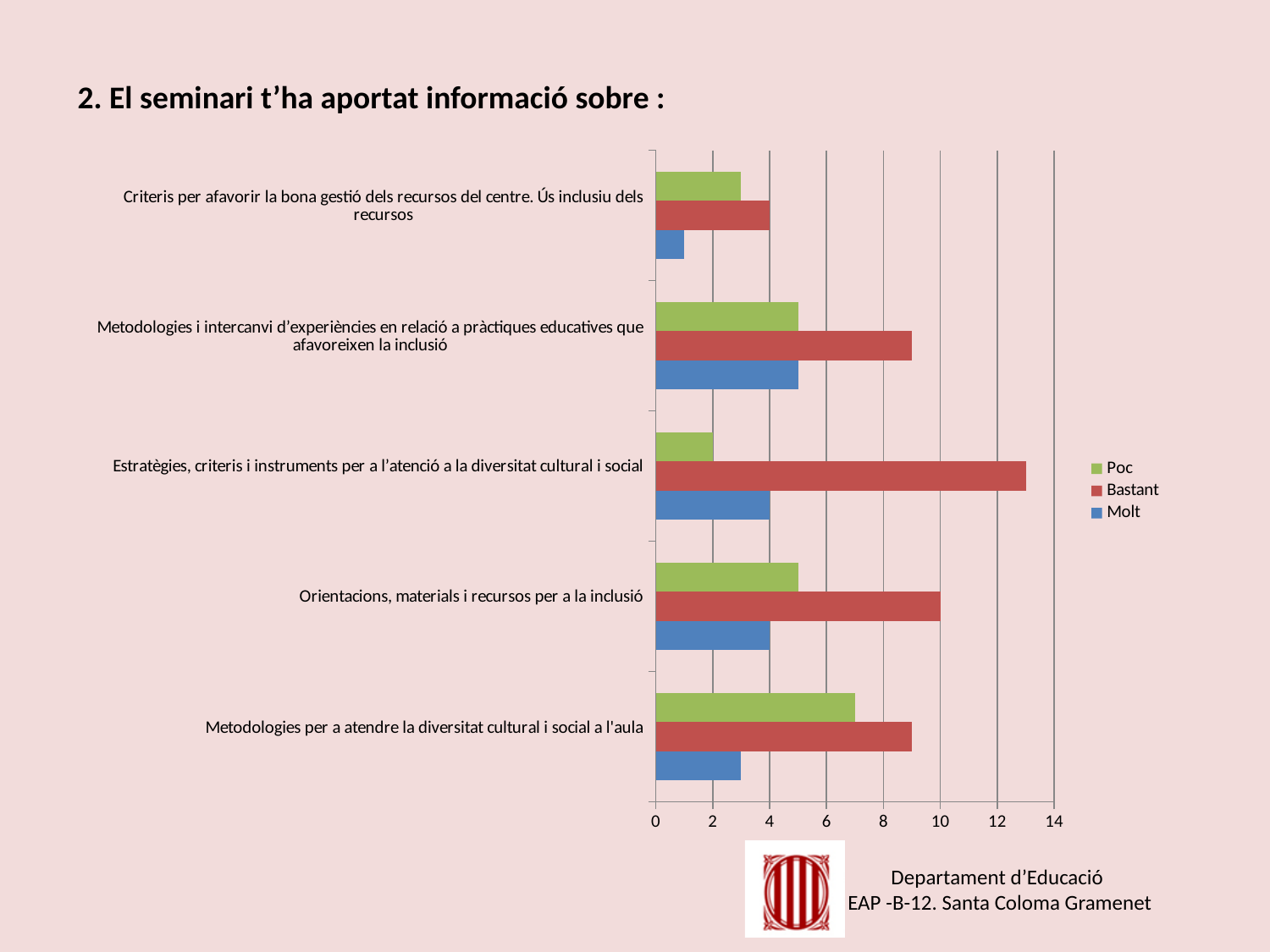
Which category has the highest 'Bastant' value? Estratègies, criteris i instruments per a l'atenció a la diversitat cultural i social How many series does the legend list? 3 For 'Estratègies, criteris i instruments per a l'atenció a la diversitat cultural i social', which is larger: the 'Bastant' value or the 'Poc' value? Bastant How many categories are plotted on the chart? 5 What is the 'Bastant' value for 'Criteris per afavorir la bona gestió dels recursos del centre. Ús inclusiu dels recursos'? 4 Is the 'Poc' value for 'Metodologies per a atendre la diversitat cultural i social a l'aula' greater or less than 6? greater Which legend entry is shown in green? Poc What is the 'Poc' value for 'Estratègies, criteris i instruments per a l'atenció a la diversitat cultural i social'? 2 What is the 'Bastant' value for 'Orientacions, materials i recursos per a la inclusió'? 10 What kind of chart is shown on the slide? bar chart Is the 'Molt' value for 'Criteris per afavorir la bona gestió dels recursos del centre. Ús inclusiu dels recursos' greater or less than 2? less Which category has the lowest 'Molt' value? Criteris per afavorir la bona gestió dels recursos del centre. Ús inclusiu dels recursos